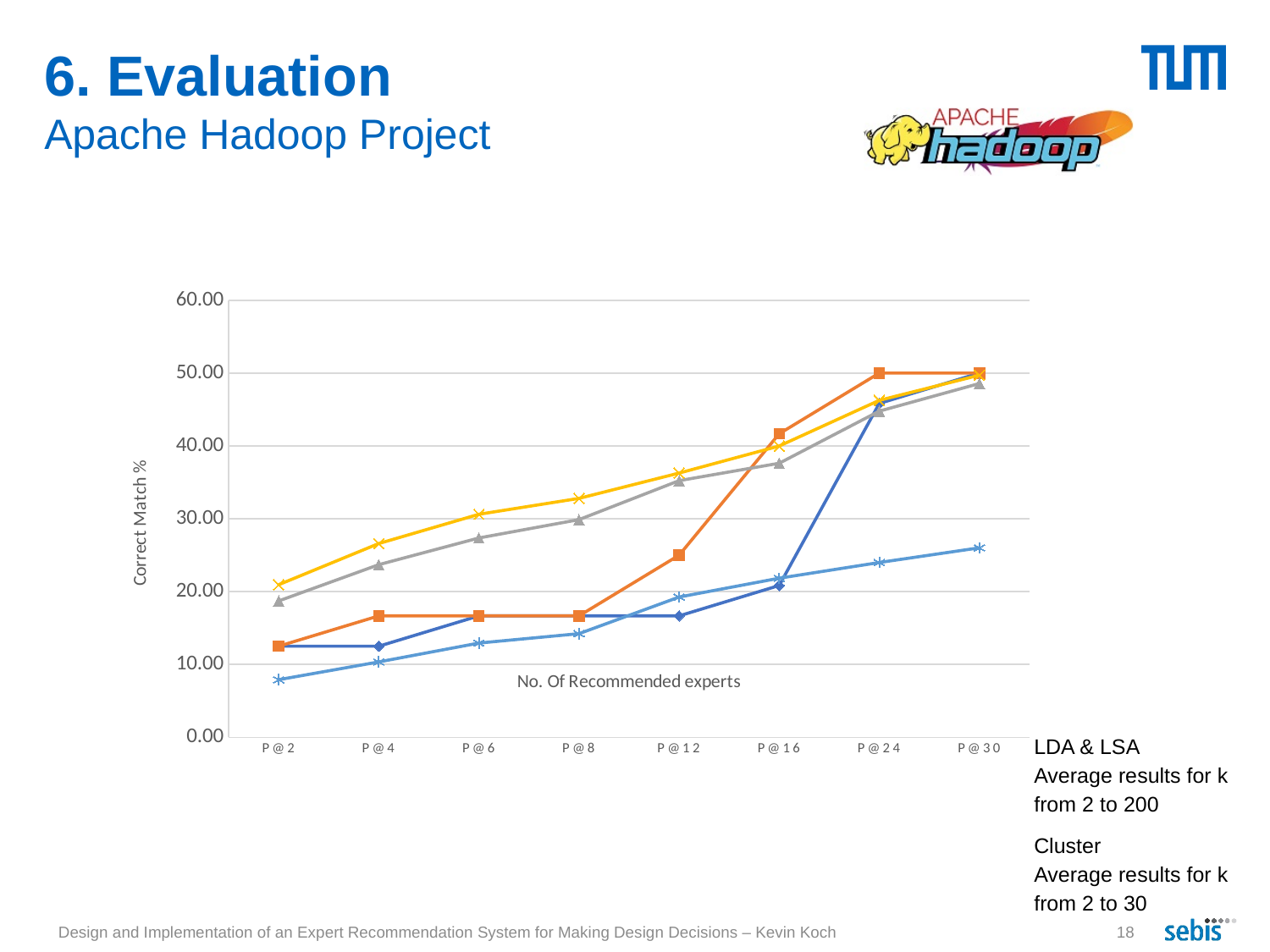
What is the label of the y axis of the chart? Correct Match % Is the value of the light blue line with asterisk markers at P@30 greater or less than 30.00? less At which category does the grey line with triangle markers have its lowest value? P@2 Do the values of the yellow line with x markers rise or fall from P@2 to P@30? rise Is the value of the orange line with square markers at P@12 greater or less than 30.00? less Is the value of the yellow line with x markers at P@8 greater or less than 30.00? greater What is the x axis title of the chart? No. Of Recommended experts What kind of chart is shown on the slide? line chart How many categories are shown along the x axis of the chart? 8 At P@12, which is larger: the value of the yellow line with x markers or the value of the orange line with square markers? yellow line with x markers At which category does the yellow line with x markers reach its highest value? P@30